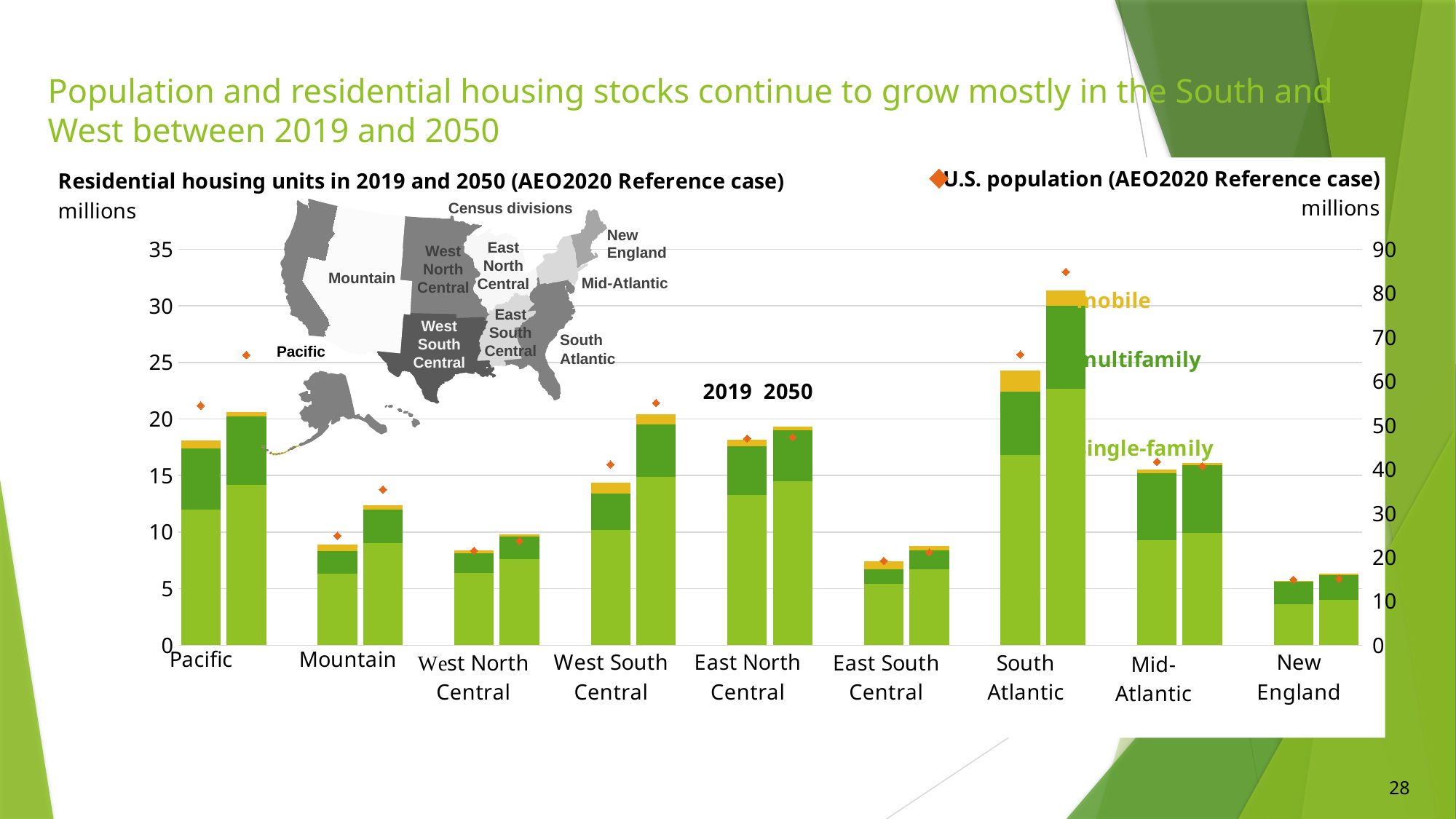
Is the U.S. population value for South Atlantic in 2050 greater or less than 80 million? greater Which census division has the shortest total housing units bar in 2019? New England Which census division has the tallest total housing units bar in 2050? South Atlantic How many census divisions are shown on the x axis of the housing units chart? 9 Which has more total housing units in 2050: Mountain or West North Central? Mountain What kind of chart is used to show residential housing units by census division? Stacked bar chart Is the total housing units value for Mountain in 2050 greater or less than 15 million? less Does the total housing stock in South Atlantic rise or fall from 2019 to 2050? Rise What colour represents mobile homes in the stacked bars? Yellow Is the total housing units value for South Atlantic in 2050 greater or less than 25 million? greater How many housing unit types does the legend list (mobile, multifamily, single-family)? 3